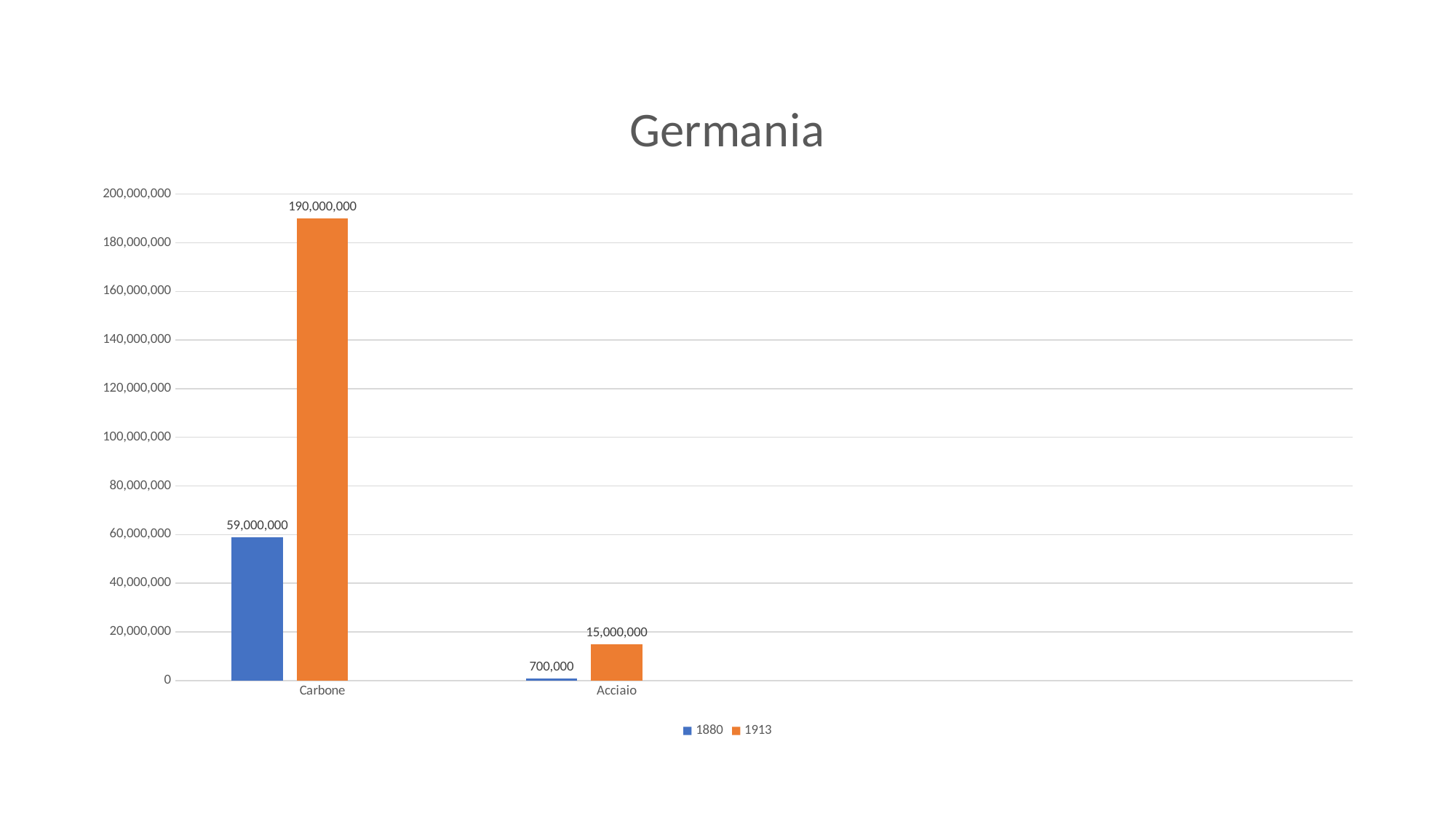
Which category has the lowest value in the 1880 series? Acciaio What is the value for Acciaio in 1913? 15,000,000 Which category has the highest value in the 1913 series? Carbone What is the value for Acciaio in 1880? 700,000 What is the difference between the 1913 and 1880 values for Carbone? 131,000,000 Which is larger: Carbone in 1880 or Acciaio in 1913? Carbone in 1880 What is the difference between the 1913 and 1880 values for Acciaio? 14,300,000 How many categories are shown on the x axis? 2 How many series does the legend list? 2 What is the value for Carbone in 1913? 190,000,000 What kind of chart is shown on the slide? Bar chart What is the value for Carbone in 1880? 59,000,000